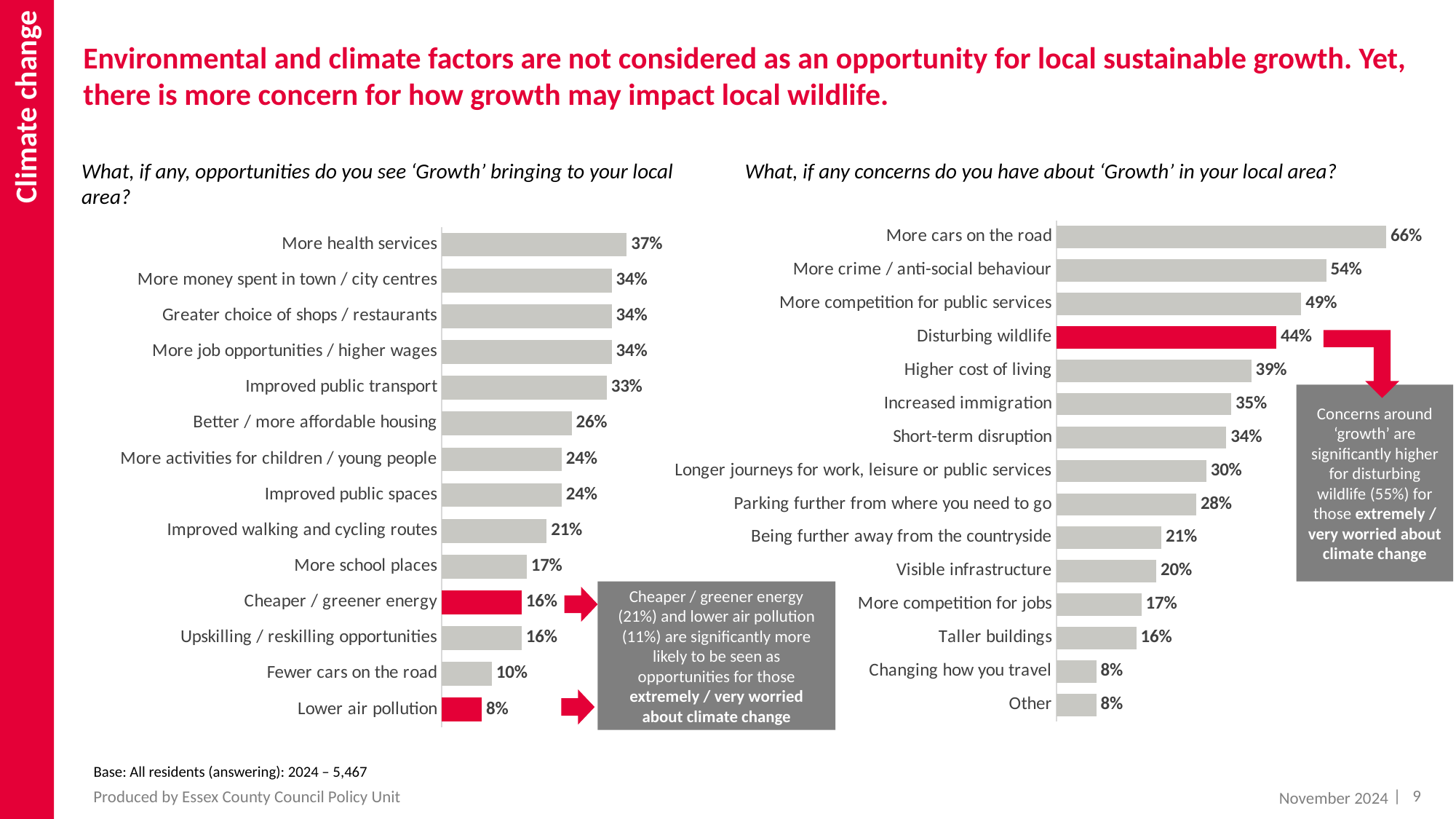
In the chart about opportunities from 'Growth' (left), which is larger: Improved public transport or Better / more affordable housing? Improved public transport In the chart about concerns about 'Growth' (right), which category has the highest value? More cars on the road In the chart about opportunities from 'Growth' (left), what percentage is shown for Fewer cars on the road? 10% How many categories are shown in the chart about concerns about 'Growth' (right)? 15 What type of chart is used for the opportunities from 'Growth' (left)? Bar chart How many categories are shown in the chart about opportunities from 'Growth' (left)? 14 In the chart about opportunities from 'Growth' (left), what percentage is shown for More health services? 37% In the chart about concerns about 'Growth' (right), what is the difference between Higher cost of living and Increased immigration? 4% In the chart about opportunities from 'Growth' (left), which category has the lowest value? Lower air pollution In the chart about concerns about 'Growth' (right), what is the difference between More cars on the road and More crime / anti-social behaviour? 12% In the chart about concerns about 'Growth' (right), what percentage is shown for Disturbing wildlife? 44% In the chart about opportunities from 'Growth' (left), which two bars are highlighted in red? Cheaper / greener energy and Lower air pollution